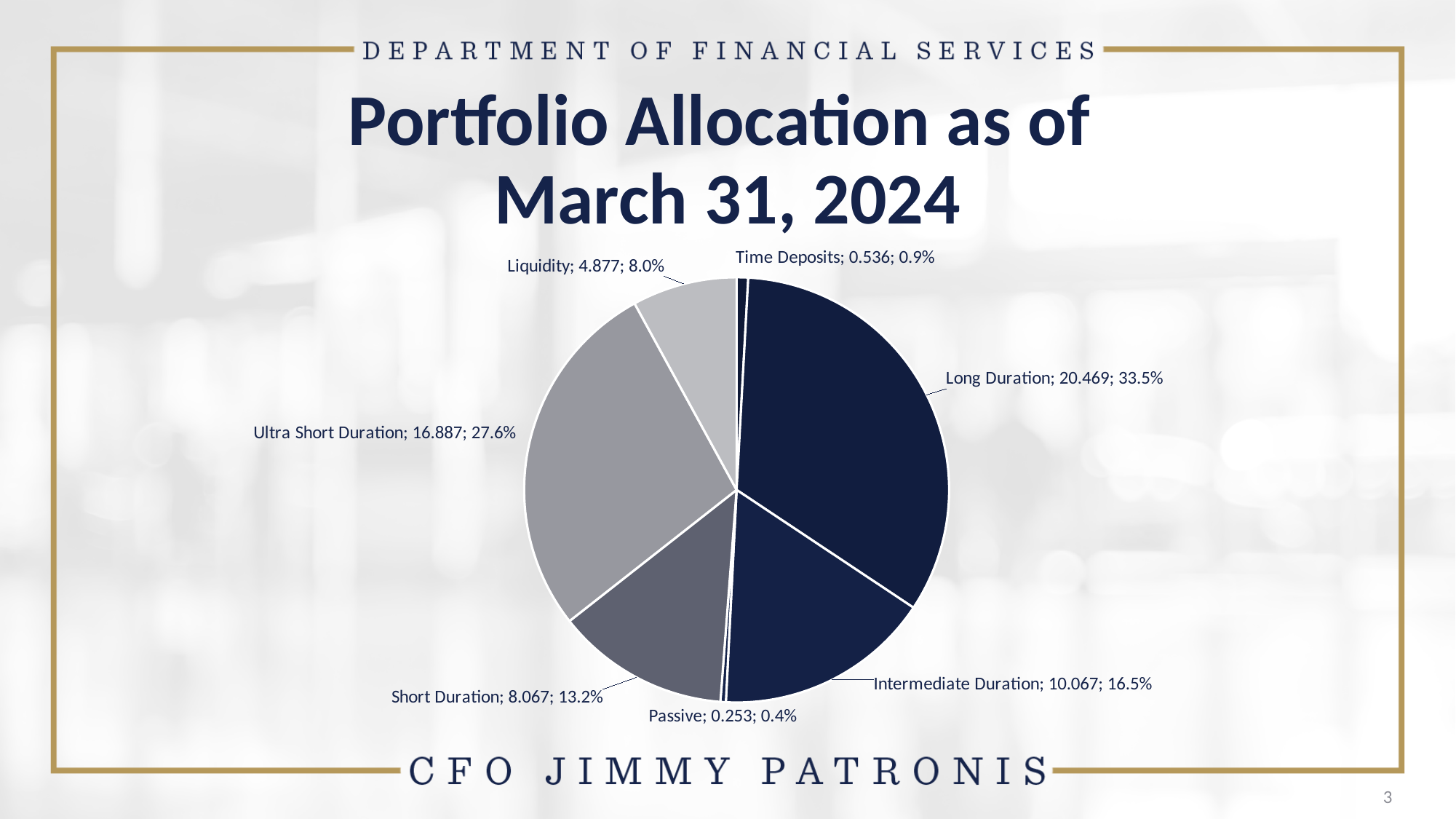
What percentage share does Ultra Short Duration have? 27.6% How many categories are shown in the pie chart? 7 What percentage share does Time Deposits have? 0.9% Which is larger, the value for Liquidity or the value for Short Duration? Short Duration What is the percentage share of Intermediate Duration? 16.5% Which category has the smallest slice of the pie? Passive Which category has the largest slice of the pie? Long Duration What is the value shown for Short Duration? 8.067 What is the title of the chart on the slide? Portfolio Allocation as of March 31, 2024 What is the value shown for Long Duration? 20.469 What kind of chart is shown on the slide? Pie chart What is the difference between the values for Long Duration and Intermediate Duration? 10.402